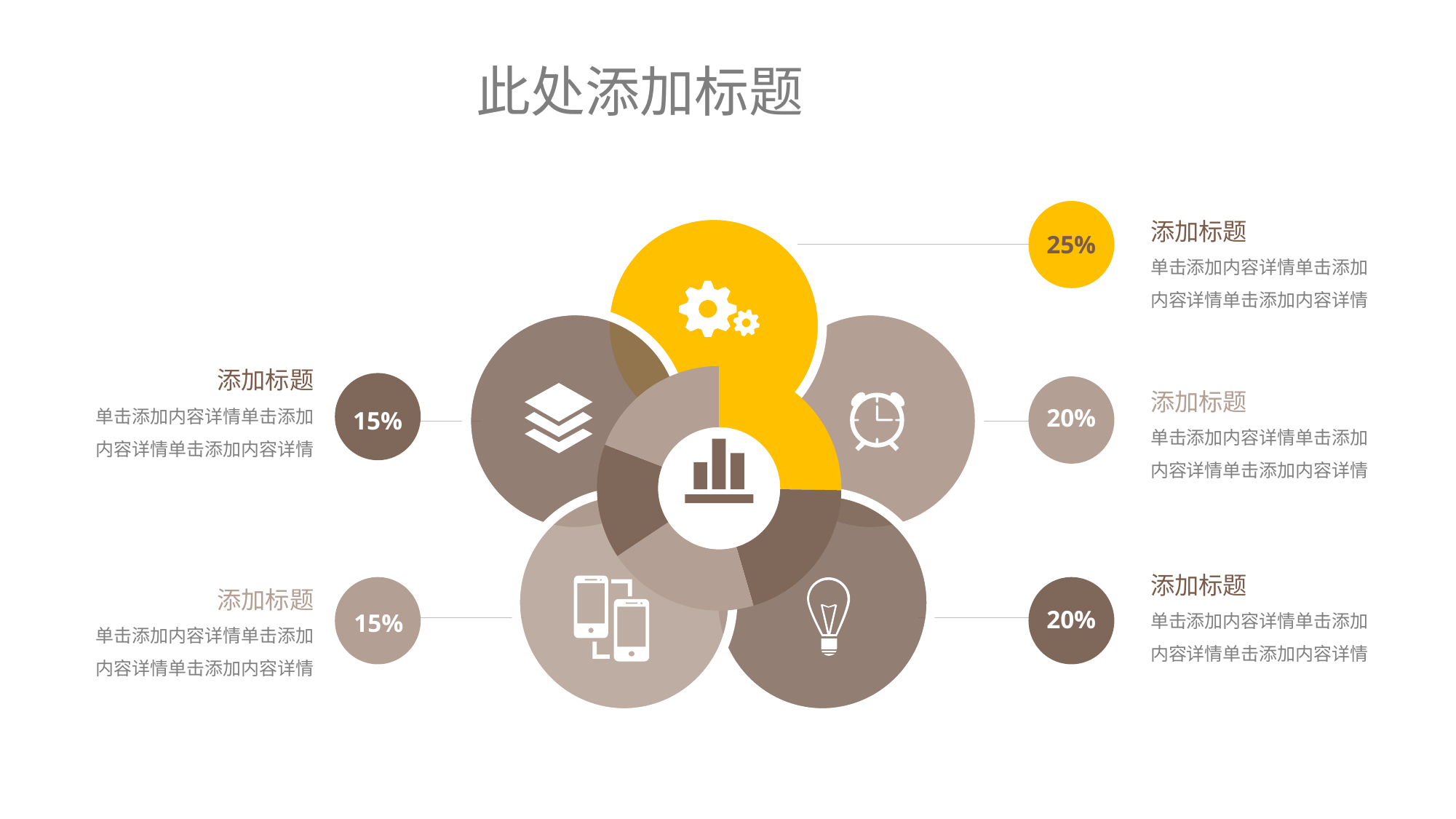
What percentage is shown in the circle on the middle right? 20% What kind of chart is shown at the centre of the slide? doughnut chart What percentage is shown in the circle on the lower left? 15% How many percentage values are shown around the diagram? 5 Which is larger, the percentage in the yellow top-right circle or the percentage in the upper-left circle? the yellow top-right circle (25%) Which percentage value shown on the slide is the highest? 25% What percentage is shown in the circle on the upper left? 15% What colour is the circle that shows 25%? yellow What is the difference between the highest percentage (25%) and the lowest percentage (15%) shown? 10% What percentage is shown in the yellow circle at the top right? 25% What percentage is shown in the dark brown circle at the bottom right? 20% How many slices does the central pie chart have? 5